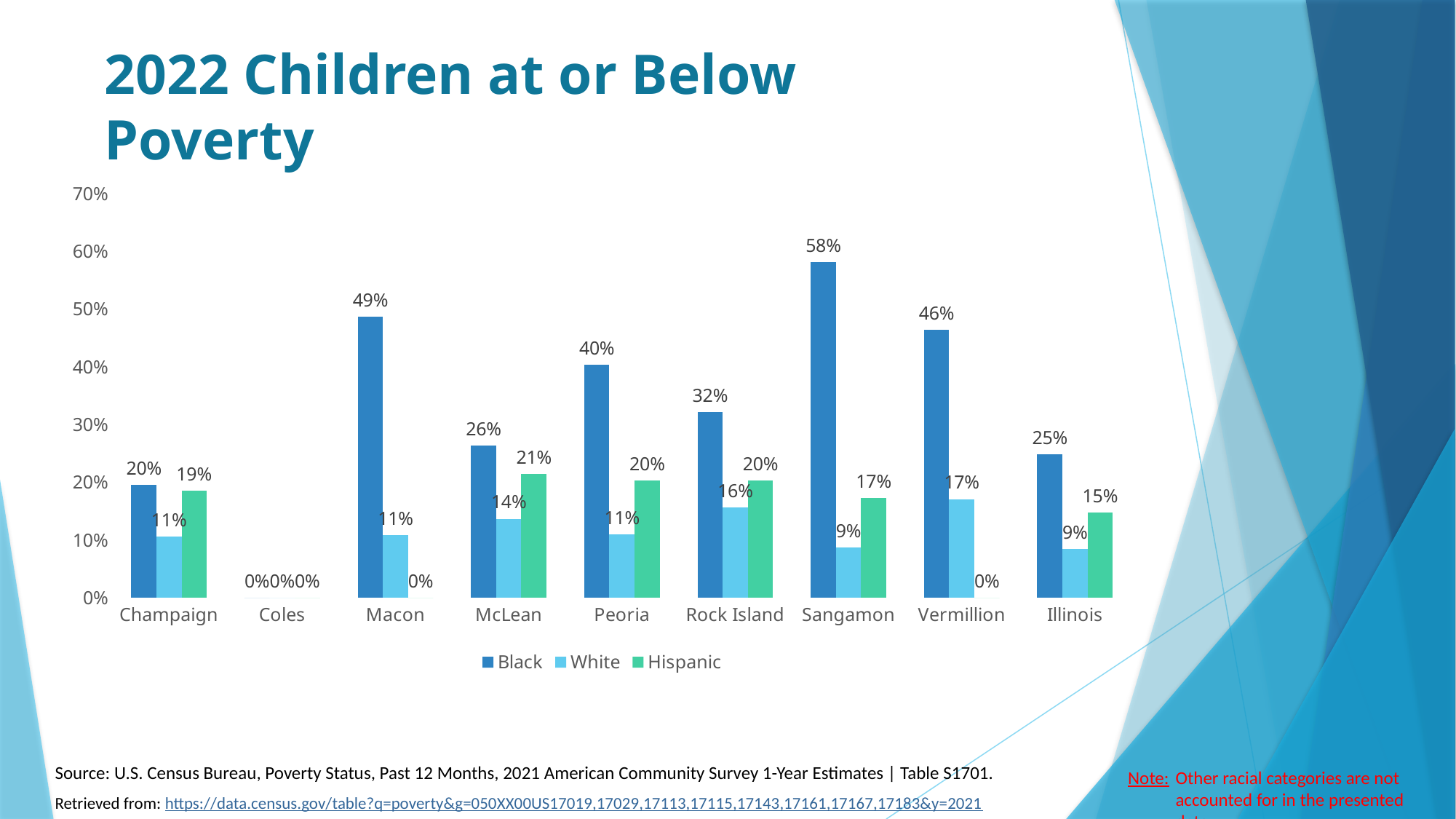
How many categories are shown on the x axis? 9 What is the value for White in Vermillion? 17% How many series does the legend list? 3 Which category has the highest value for the Black series? Sangamon Is the Black value for Vermillion greater or less than 40%? greater What is the value for Hispanic in McLean? 21% Which is larger, the Black value for Peoria or the Black value for Rock Island? Peoria What is the title of the slide? 2022 Children at or Below Poverty Which category has the lowest value for the Hispanic series, excluding the 0% values? Illinois What is the value for Black in Sangamon? 58% What kind of chart is shown on the slide? bar chart What is the difference between the Black and White values for Macon? 38%